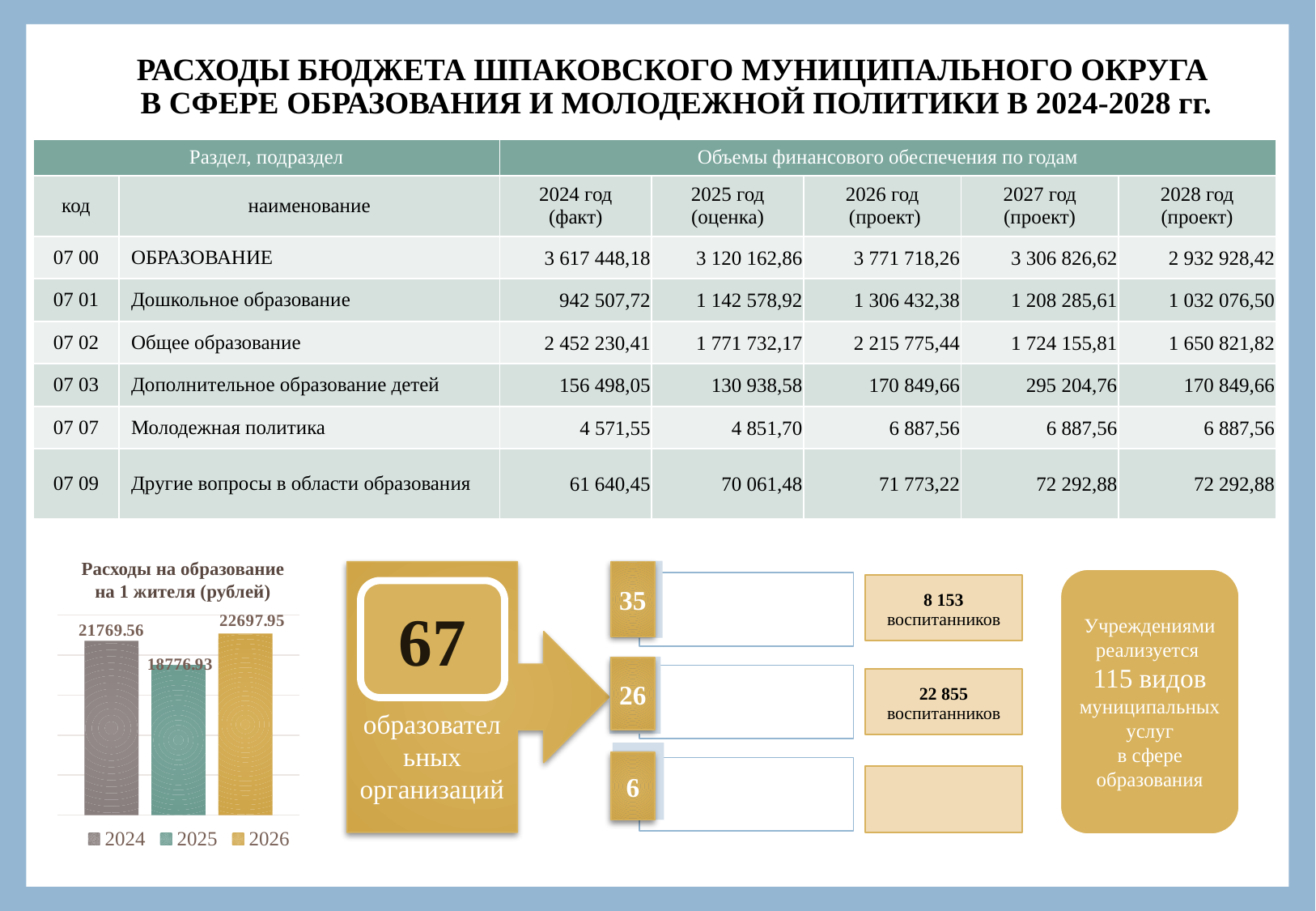
In the chart 'Расходы на образование на 1 жителя (рублей)', which year has the lowest value? 2025 In the chart 'Расходы на образование на 1 жителя (рублей)', what is the value for 2026? 22697.95 In the chart 'Расходы на образование на 1 жителя (рублей)', does the value rise or fall from 2024 to 2025? fall In the chart 'Расходы на образование на 1 жителя (рублей)', what is the difference between the 2026 and 2024 values? 928.39 In the chart 'Расходы на образование на 1 жителя (рублей)', what is the value for 2025? 18776.93 How many bars are plotted in the chart 'Расходы на образование на 1 жителя (рублей)'? 3 In the chart 'Расходы на образование на 1 жителя (рублей)', which is larger, the value for 2024 or the value for 2025? 2024 In the chart 'Расходы на образование на 1 жителя (рублей)', what is the difference between the 2024 and 2025 values? 2992.63 How many entries does the legend of the chart 'Расходы на образование на 1 жителя (рублей)' list? 3 In the chart 'Расходы на образование на 1 жителя (рублей)', what is the value for 2024? 21769.56 In the chart 'Расходы на образование на 1 жителя (рублей)', which year has the highest value? 2026 What kind of chart is 'Расходы на образование на 1 жителя (рублей)'? bar chart